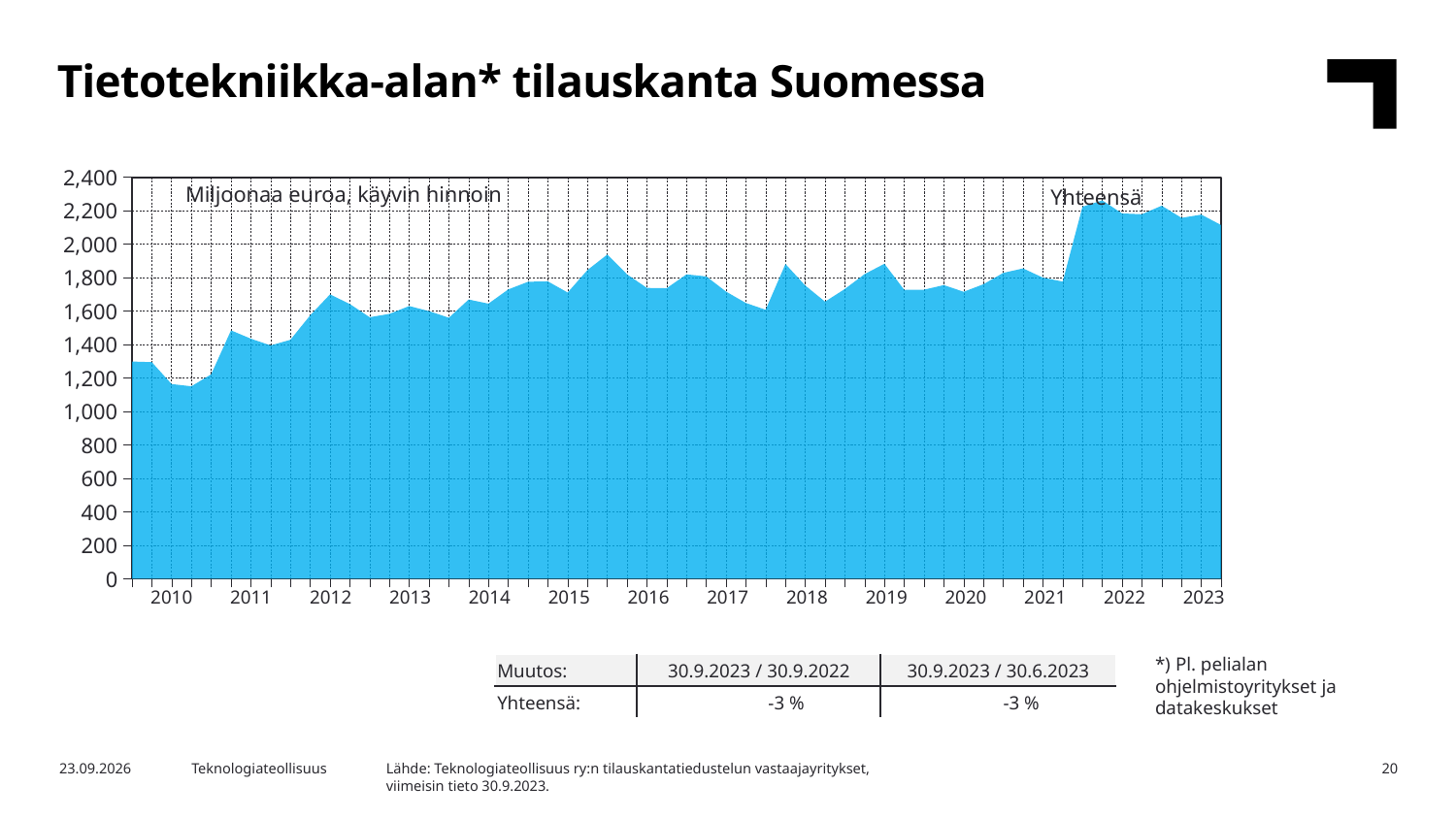
What unit is the chart's data expressed in, according to the label inside the plot area? Miljoonaa euroa, käyvin hinnoin How many years are labelled on the x axis of the chart? 14 In which year does the chart reach its highest values? 2022 Is the lowest value in 2010 greater or less than 1,400? less Does the order backlog rise or fall between 2021 and 2022? rise Is the value at the end of 2023 greater or less than 2,000? greater In which year does the chart show its lowest values? 2010 Is the peak value in 2022 greater or less than 2,400? less Is the value in 2022 larger or smaller than the value in 2010? larger What kind of chart is shown on the slide? area chart What is the name of the series plotted in the chart? Yhteensä What is the title of the slide's chart? Tietotekniikka-alan* tilauskanta Suomessa